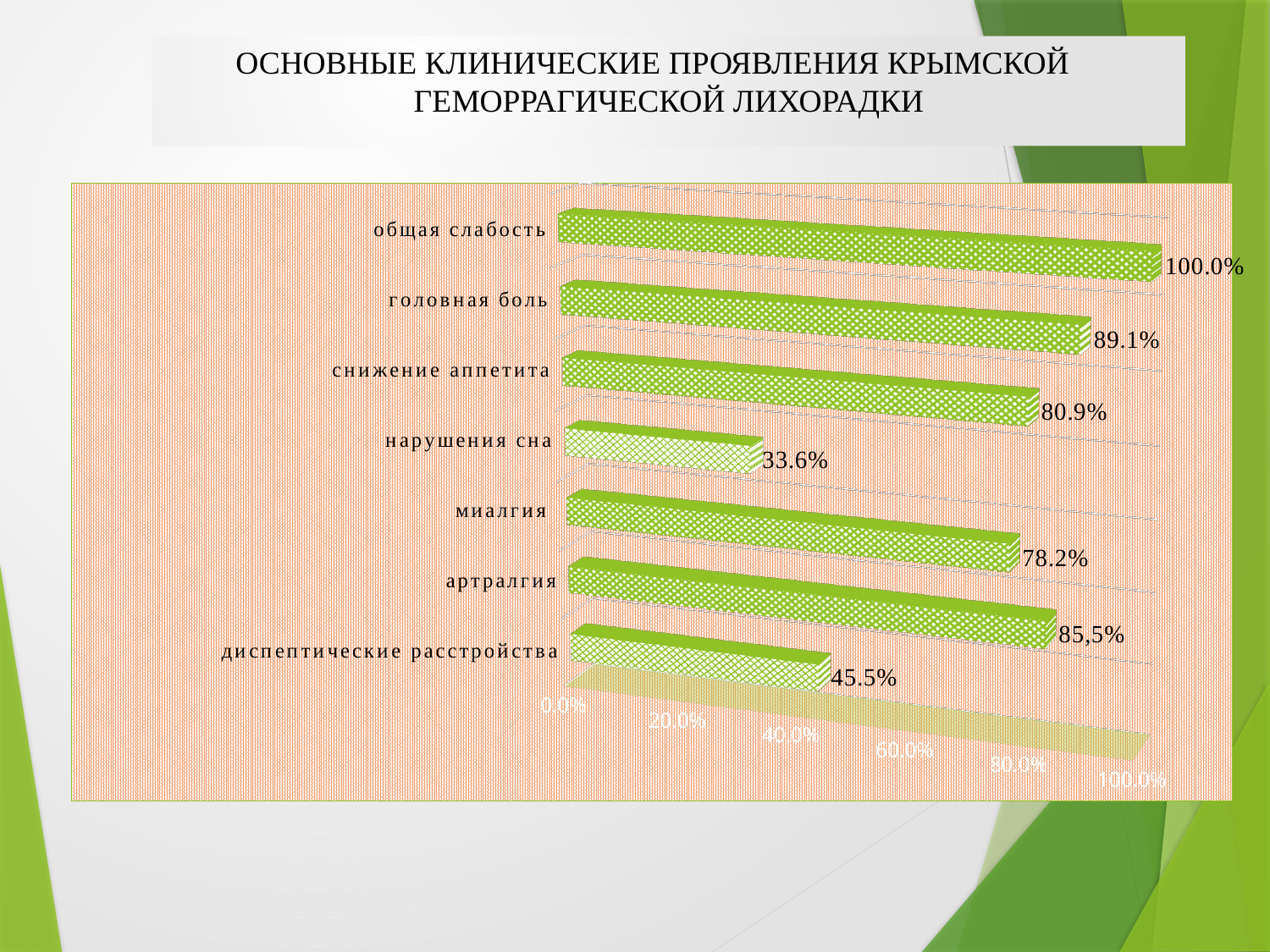
What is the value for головная боль? 89.1% How many categories are shown in the chart? 7 Which category has the lowest value? нарушения сна What is the value for нарушения сна? 33.6% What is the value for диспептические расстройства? 45.5% What is the value for общая слабость? 100.0% Which is larger, the value for миалгия or the value for снижение аппетита? снижение аппетита What kind of chart is shown on the slide? bar chart What is the difference between the values for головная боль and снижение аппетита? 8.2% Which category has the highest value? общая слабость Is the value for диспептические расстройства greater or less than 60.0%? less What is the value for артралгия? 85,5%